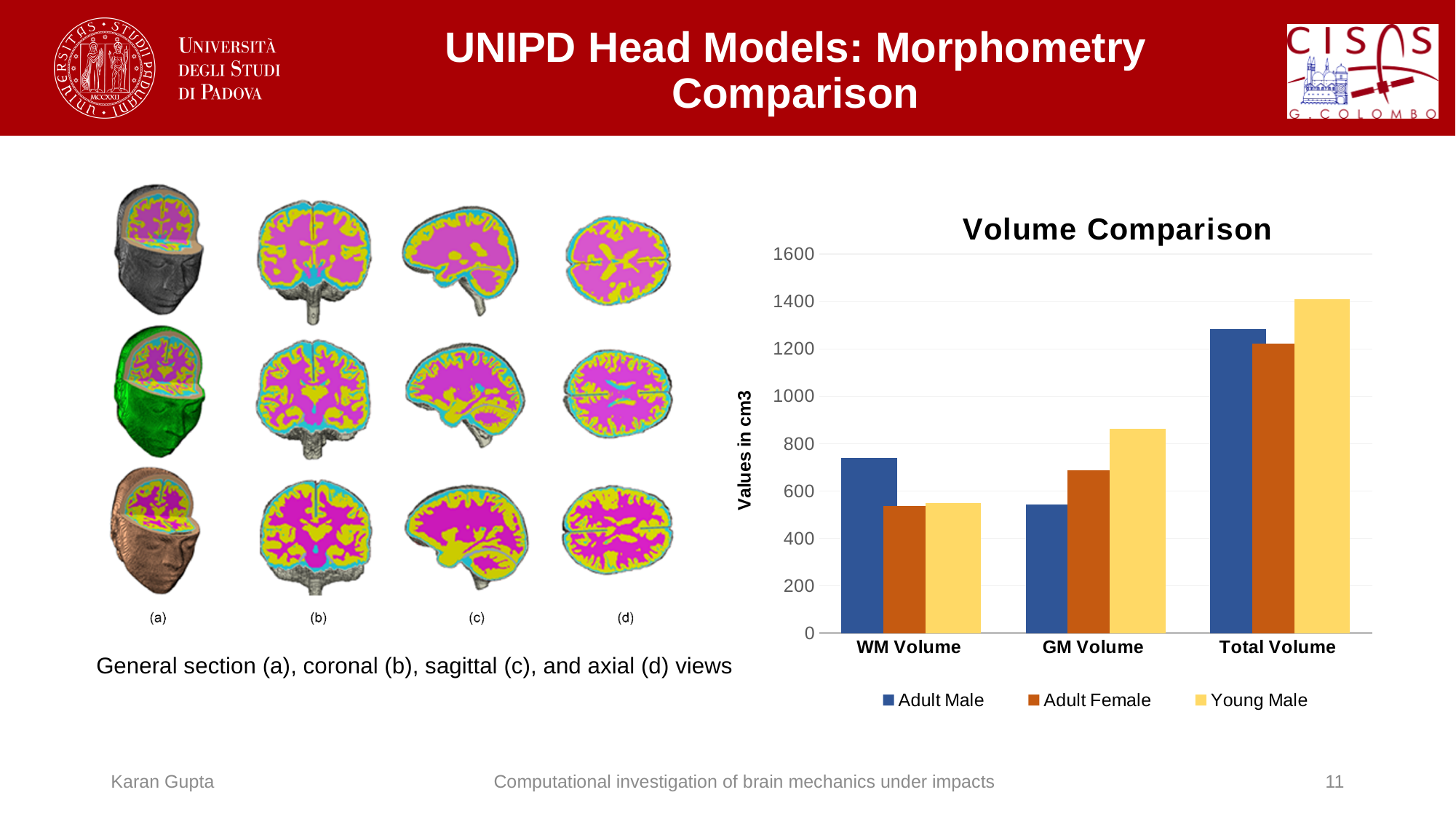
Is the GM Volume for Young Male greater or less than 800? greater How many series does the legend of the Volume Comparison chart list? 3 What type of chart is the Volume Comparison chart? bar chart Is the GM Volume for Adult Male greater or less than 600? less Which series has the lowest GM Volume in the Volume Comparison chart? Adult Male Is the WM Volume for Adult Male greater or less than 600? greater Which is larger in the Volume Comparison chart: the GM Volume for Adult Female or the GM Volume for Adult Male? Adult Female What is the y-axis label of the Volume Comparison chart? Values in cm3 Which series has the highest Total Volume in the Volume Comparison chart? Young Male Which series has the highest WM Volume in the Volume Comparison chart? Adult Male How many categories are shown on the x axis of the Volume Comparison chart? 3 Which series has the highest GM Volume in the Volume Comparison chart? Young Male